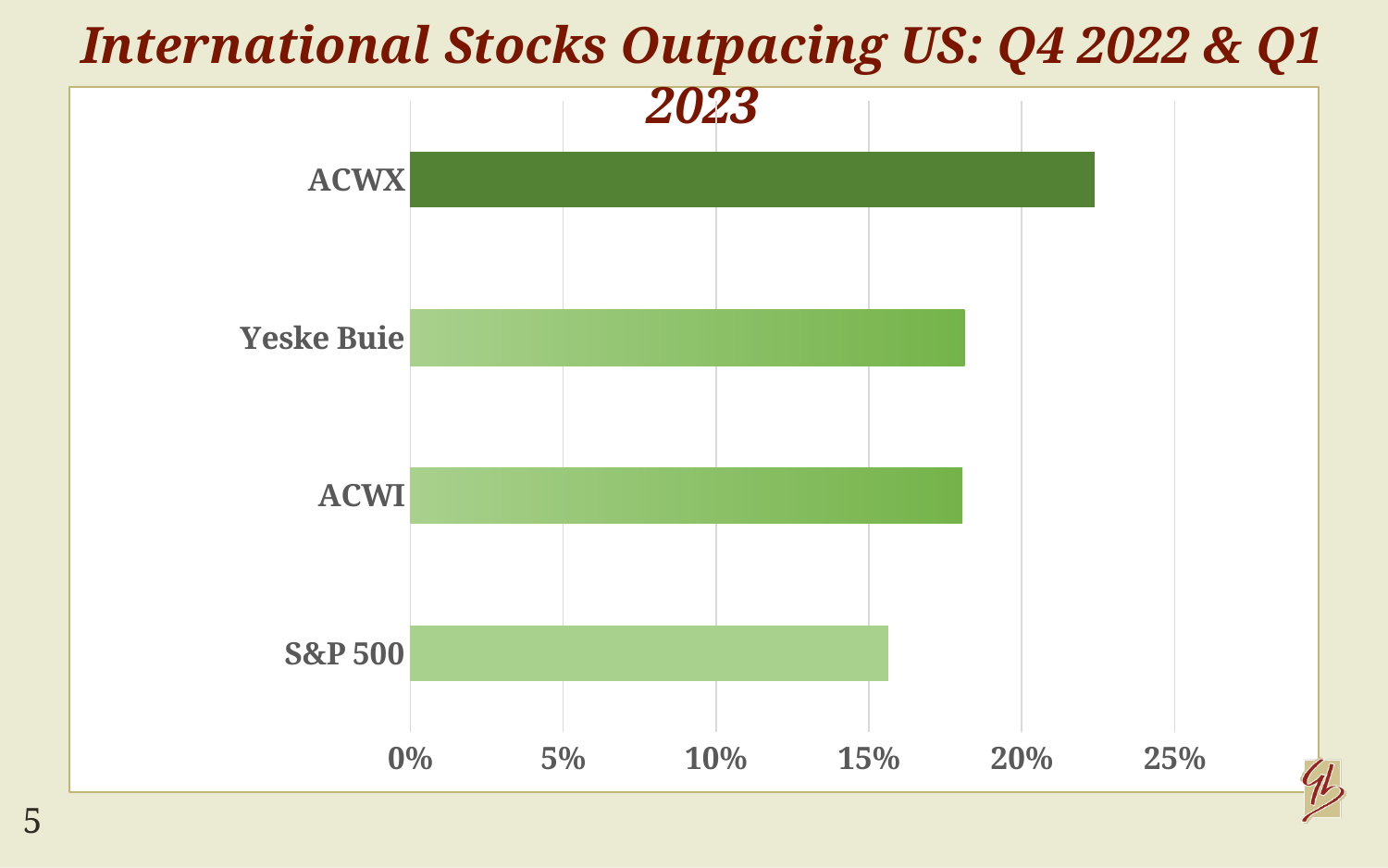
Is the value for Yeske Buie greater or less than 20%? less What is the title of the chart? International Stocks Outpacing US: Q4 2022 & Q1 2023 Is the value for ACWI greater or less than 15%? greater Which is larger, the value for ACWX or the value for S&P 500? ACWX What kind of chart is shown on the slide? bar chart How many categories are plotted in the chart? 4 Which category has the highest value in the chart? ACWX Is the value for S&P 500 greater or less than 15%? greater Which is larger, the value for Yeske Buie or the value for S&P 500? Yeske Buie Which category has the lowest value in the chart? S&P 500